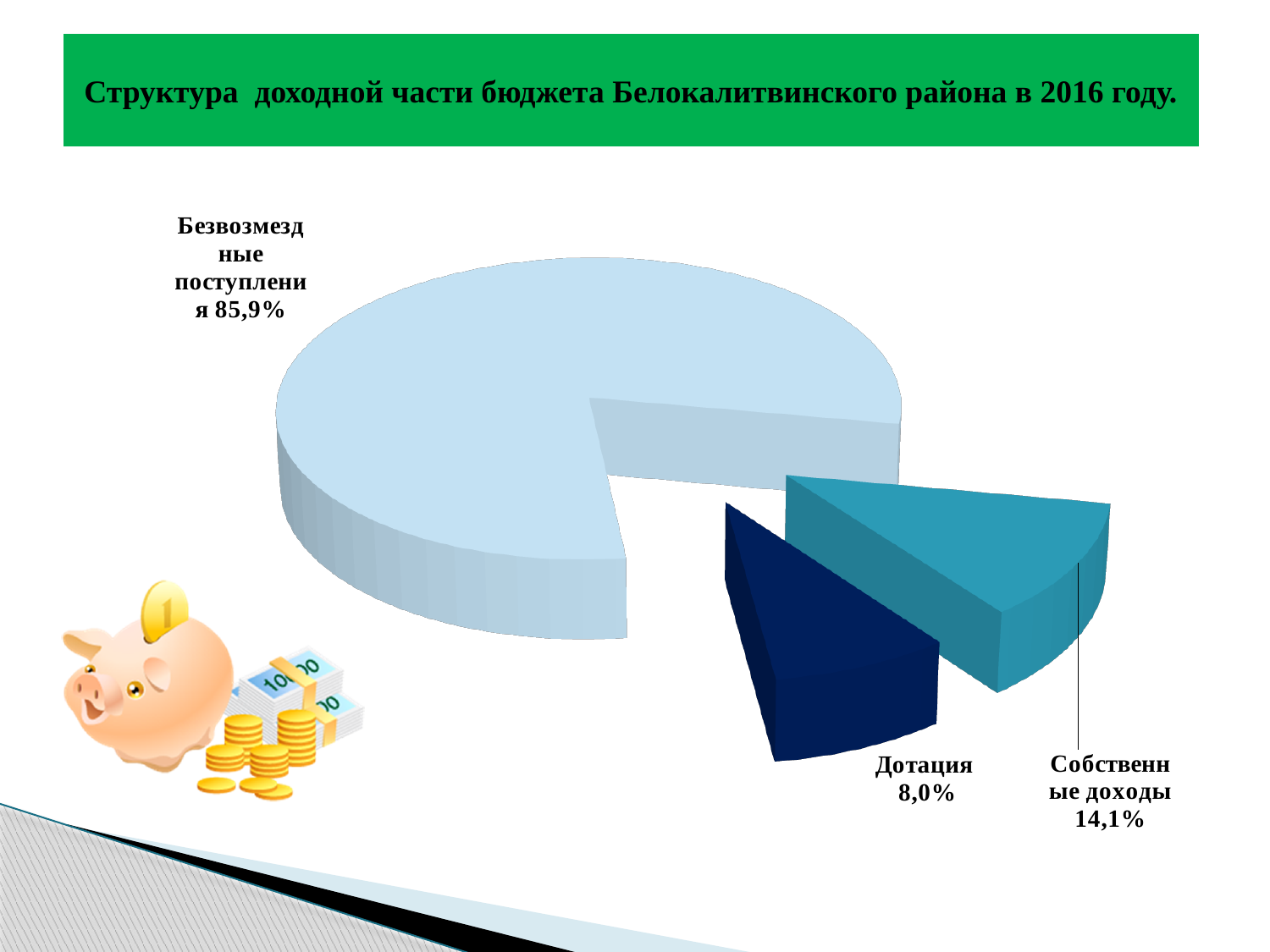
What is the difference between the values for Безвозмездные поступления and Собственные доходы? 71,8% Which is larger, Собственные доходы or Дотация? Собственные доходы What is the difference between the values for Собственные доходы and Дотация? 6,1% Which category has the largest slice of the pie? Безвозмездные поступления What is the value shown for Собственные доходы? 14,1% What kind of chart is shown on the slide? Pie chart How many slices does the pie chart have? 3 Which slice is coloured dark navy blue? Дотация Which category has the smallest slice of the pie? Дотация What is the title of the slide? Структура доходной части бюджета Белокалитвинского района в 2016 году. What share of the pie does Безвозмездные поступления hold? 85,9% What is the value shown for Дотация? 8,0%